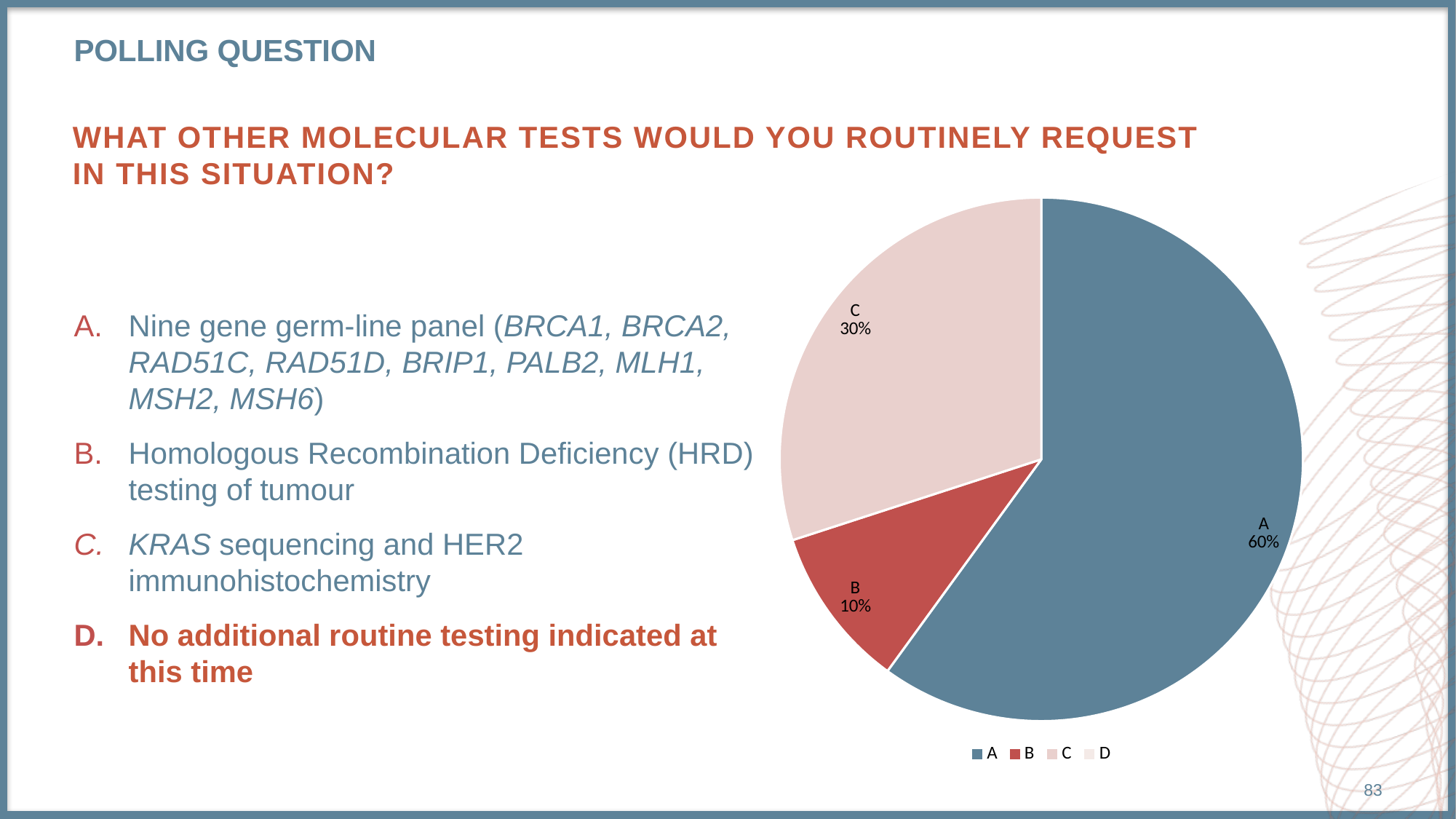
What is the difference in percentage points between slice A and slice C? 30 What share of the pie does slice A represent? 60% What colour is slice B in the pie chart? Red Which slice is larger, B or C? C What is the difference in percentage points between slice C and slice B? 20 Which slice of the pie chart is the largest? A Which labelled slice of the pie chart is the smallest? B What percentage of the pie chart is labelled for slice B? 10% What percentage of the pie chart is labelled for slice C? 30% How many entries does the chart legend list? 4 What percentage of the pie chart is labelled for slice A? 60% What kind of chart is shown on the slide? Pie chart